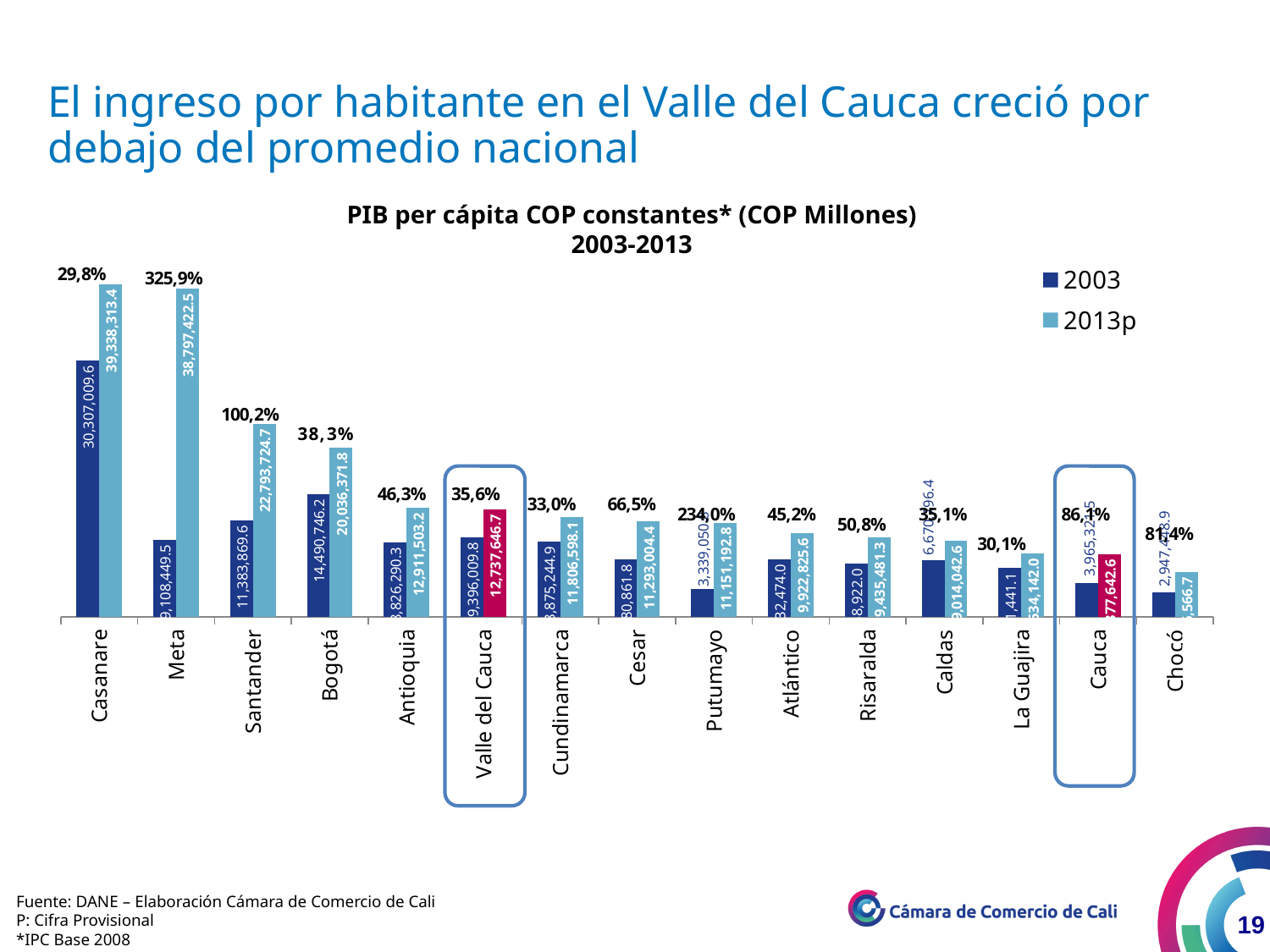
How many departments are shown on the x axis of the chart? 15 Which department shows the highest growth percentage between 2003 and 2013? Meta What is the difference between the 2013p and 2003 PIB per cápita values for Bogotá? 5,545,625.6 Which has the larger 2013p PIB per cápita, Antioquia or Valle del Cauca? Antioquia Which department has the highest 2003 PIB per cápita? Casanare What is the 2003 PIB per cápita value for Valle del Cauca? 9,396,009.8 What kind of chart is shown on the slide? Bar chart What is the 2013p PIB per cápita value for Valle del Cauca? 12,737,646.7 Which two departments are highlighted with a rounded box on the chart? Valle del Cauca and Cauca How many series does the legend list? 2 What is the 2013p PIB per cápita value for Casanare? 39,338,313.4 What growth percentage is shown above the bars for Meta? 325,9%